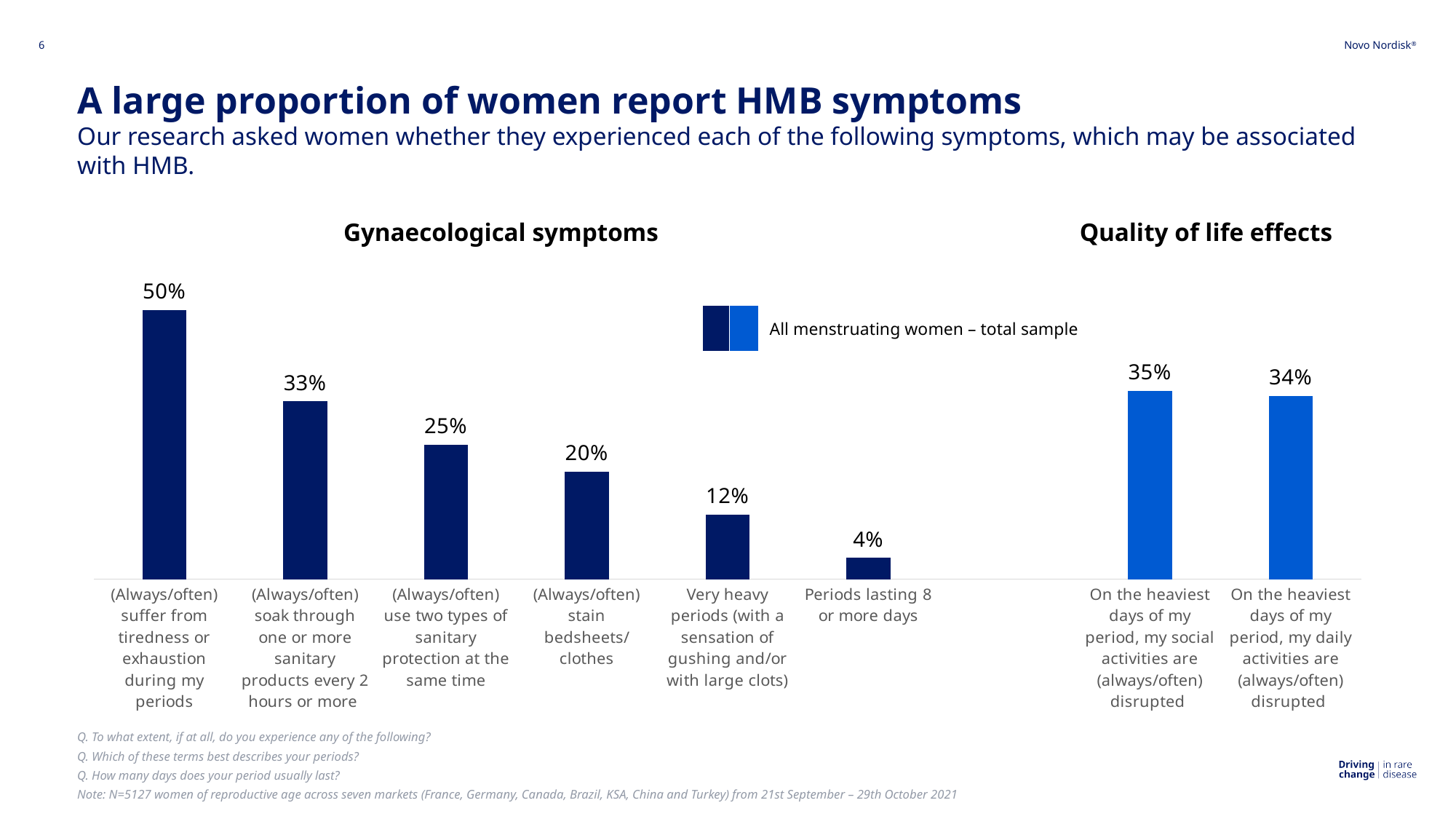
What percentage of women report very heavy periods (with a sensation of gushing and/or with large clots)? 12% Which gynaecological symptom has the lowest reported percentage? Periods lasting 8 or more days How many quality of life effects are shown in the chart? 2 What percentage of women report that they (always/often) suffer from tiredness or exhaustion during their periods? 50% How many gynaecological symptoms are shown in the chart? 6 Which is larger: the percentage reporting social activities disrupted or the percentage reporting daily activities disrupted on the heaviest days of their period? Social activities disrupted (35%) What does the legend say the bars represent? All menstruating women – total sample What percentage of women report periods lasting 8 or more days? 4% What percentage of women report that on the heaviest days of their period their social activities are (always/often) disrupted? 35% What type of chart is shown on the slide? Bar chart Which gynaecological symptom has the highest reported percentage? (Always/often) suffer from tiredness or exhaustion during my periods What is the difference between the percentage who (always/often) soak through one or more sanitary products every 2 hours or more and the percentage who (always/often) stain bedsheets/clothes? 13%